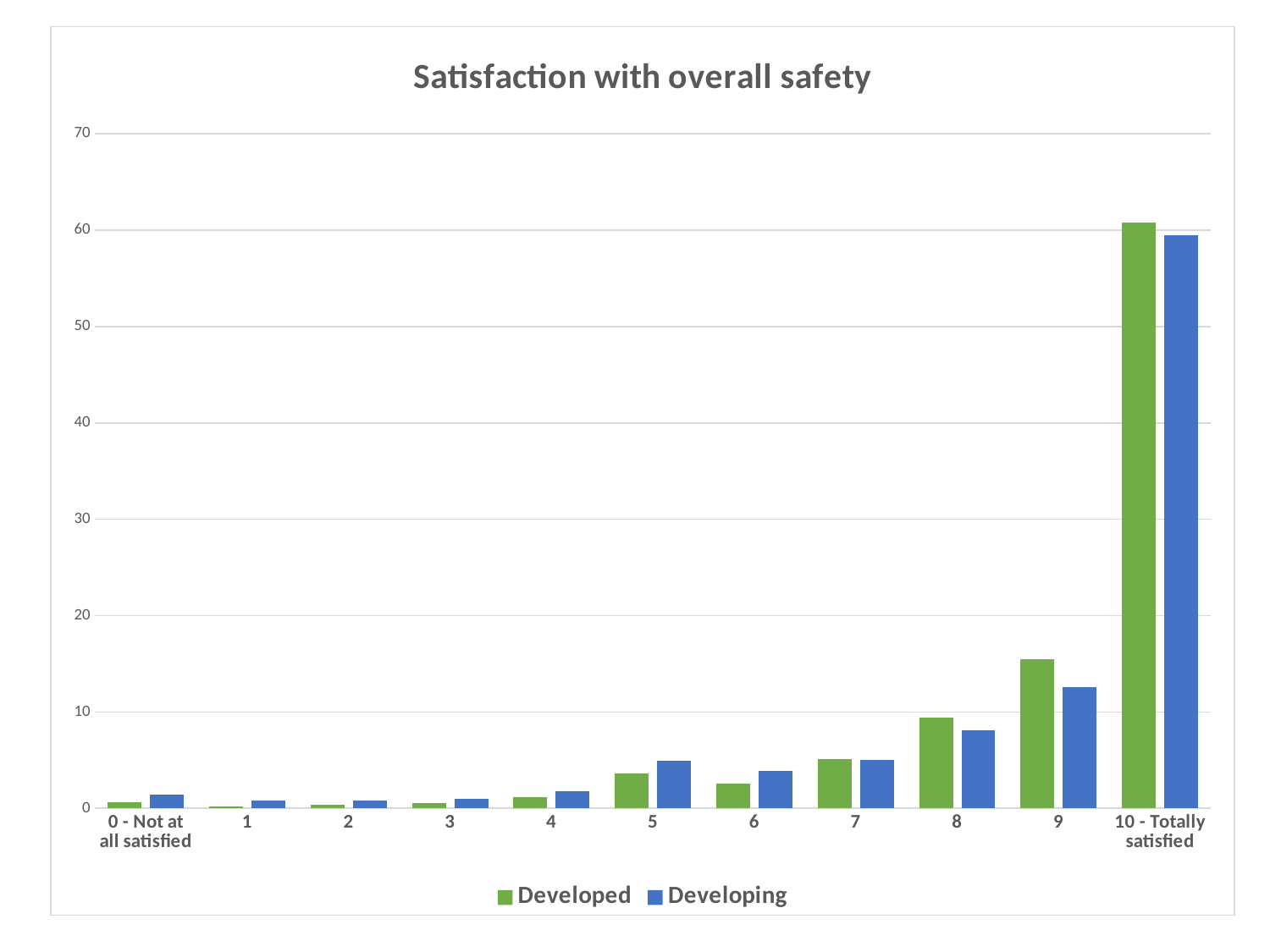
Which category has the lowest value for the Developed series? 1 How many series does the legend list? 2 Which category has the highest value for the Developed series? 10 - Totally satisfied Which category has the highest value for the Developing series? 10 - Totally satisfied What is the title of the chart? Satisfaction with overall safety What kind of chart is shown on the slide? Bar chart Is the Developing value for 10 - Totally satisfied greater or less than 50? greater Is the Developed value for 9 greater or less than 10? greater For category 5, which series has the larger value, Developed or Developing? Developing How many categories are shown on the x axis? 11